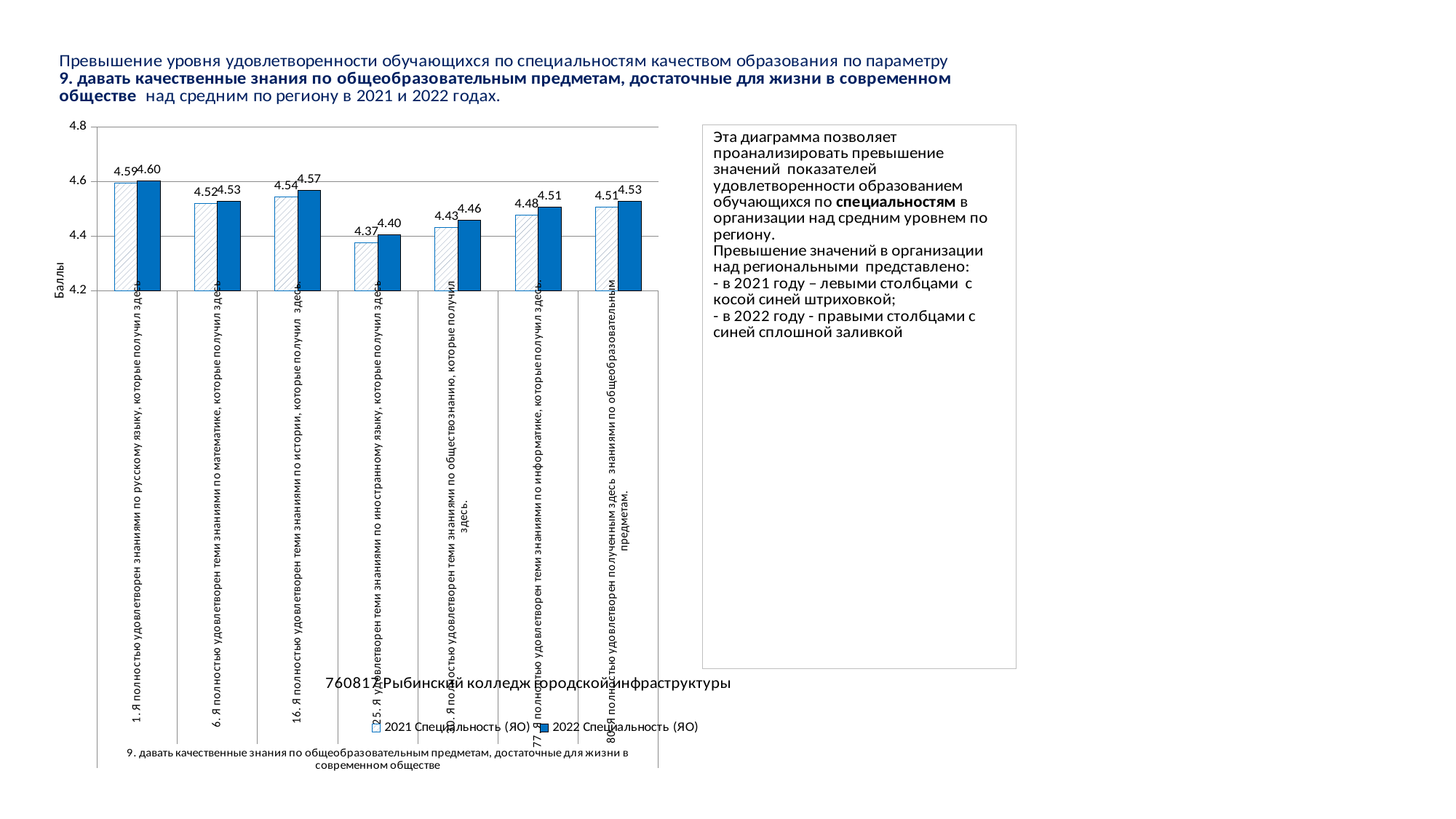
Which is larger: the 2021 value for the category about informatics (77. ...по информатике) or the 2021 value for the category about social studies (...по обществознанию)? 77. ...по информатике (4.48) What is the difference between the 2022 and 2021 values for the category about knowledge of history (16. ...по истории)? 0.03 Which category has the highest 2021 value? 1. Я полностью удовлетворен знаниями по русскому языку, которые получил здесь How many categories (questions) are plotted on the x axis? 7 Which category has the lowest 2022 value? 25. Я удовлетворен теми знаниями по иностранному языку, которые получил здесь What is the 2021 value for the category about knowledge of history (16. ...по истории)? 4.54 Is the 2022 value for the category about mathematics (6. ...по математике) greater or less than 4.4? greater What kind of chart is shown on the slide? bar chart What is the 2021 value for the category about knowledge of a foreign language (25. ...по иностранному языку)? 4.37 What is the label of the y axis? Баллы How many series does the legend list? 2 What is the 2022 value for the category about knowledge of the Russian language (1. Я полностью удовлетворен знаниями по русскому языку)? 4.60